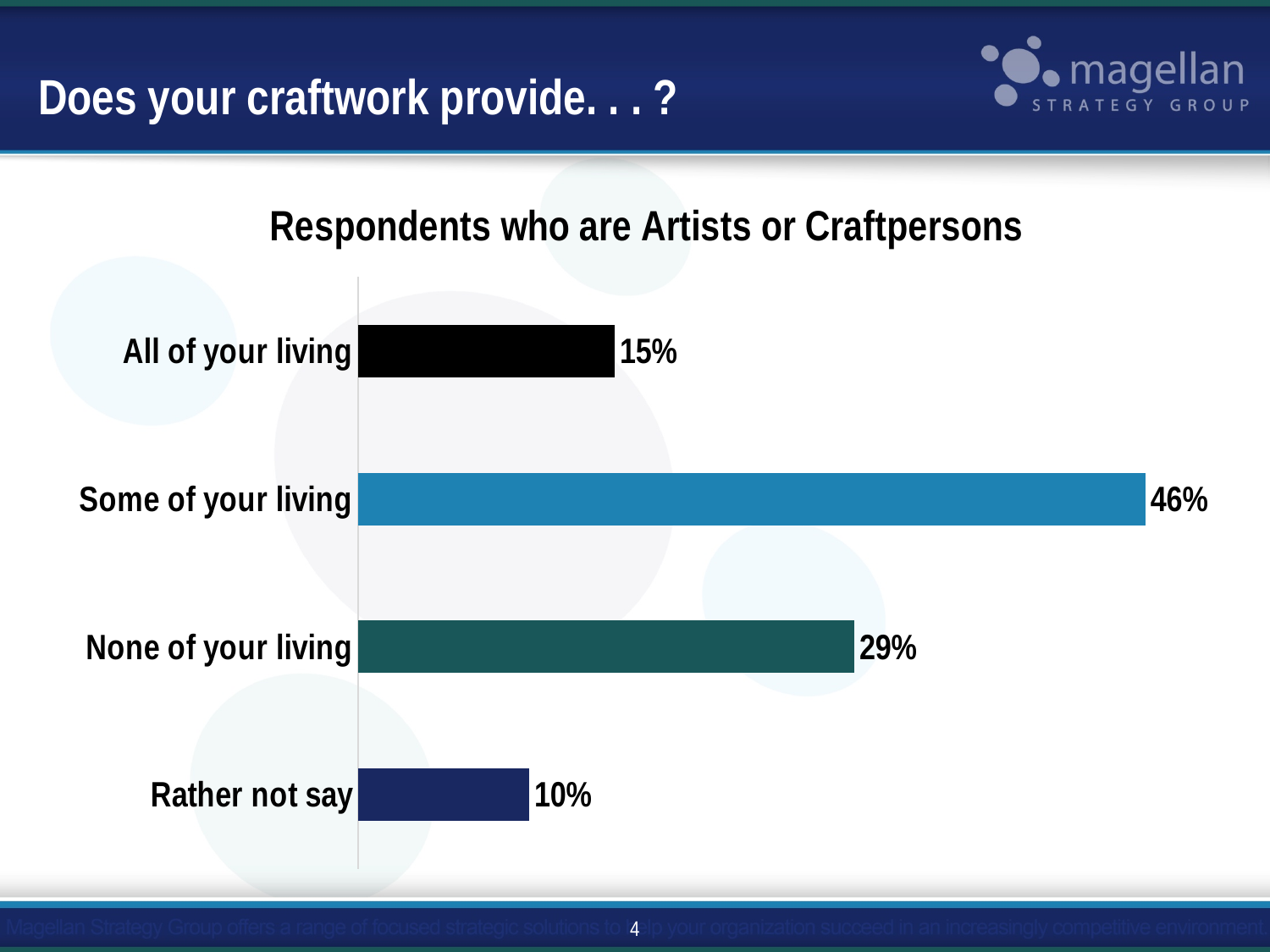
What percentage of respondents said their craftwork provides some of their living? 46% What is the difference in percentage points between 'All of your living' and 'Rather not say'? 5 What percentage of respondents said their craftwork provides all of their living? 15% What is the difference in percentage points between 'Some of your living' and 'None of your living'? 17 What is the title of the chart? Respondents who are Artists or Craftpersons What type of chart is shown on the slide? Bar chart Which category has the highest percentage? Some of your living How many categories are shown in the chart? 4 Which category has the lowest percentage? Rather not say Which is larger: the value for 'None of your living' or the value for 'All of your living'? None of your living What percentage of respondents said their craftwork provides none of their living? 29% What percentage of respondents chose 'Rather not say'? 10%